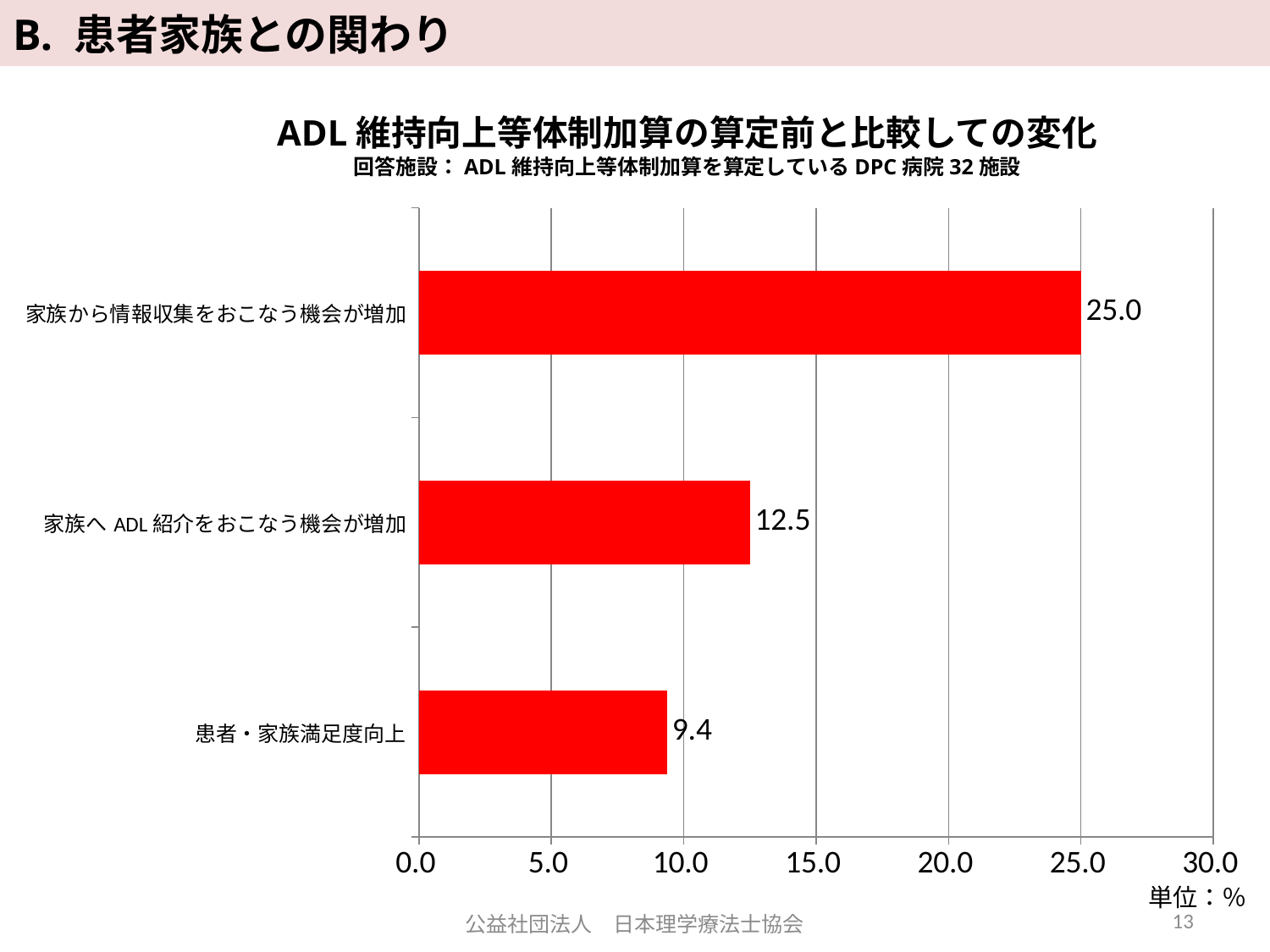
What kind of chart is shown on the slide? bar chart Is the value for 患者・家族満足度向上 greater or less than 10.0? less Which category has the highest value? 家族から情報収集をおこなう機会が増加 What is the value for 家族から情報収集をおこなう機会が増加? 25.0 Which is larger, the value for 家族へADL紹介をおこなう機会が増加 or the value for 患者・家族満足度向上? 家族へADL紹介をおこなう機会が増加 How many categories are shown in the chart? 3 Which category has the lowest value? 患者・家族満足度向上 What is the value for 患者・家族満足度向上? 9.4 What is the difference between the values for 家族へADL紹介をおこなう機会が増加 and 患者・家族満足度向上? 3.1 What is the difference between the values for 家族から情報収集をおこなう機会が増加 and 家族へADL紹介をおこなう機会が増加? 12.5 What is the value for 家族へADL紹介をおこなう機会が増加? 12.5 What is the title of the chart? ADL維持向上等体制加算の算定前と比較しての変化